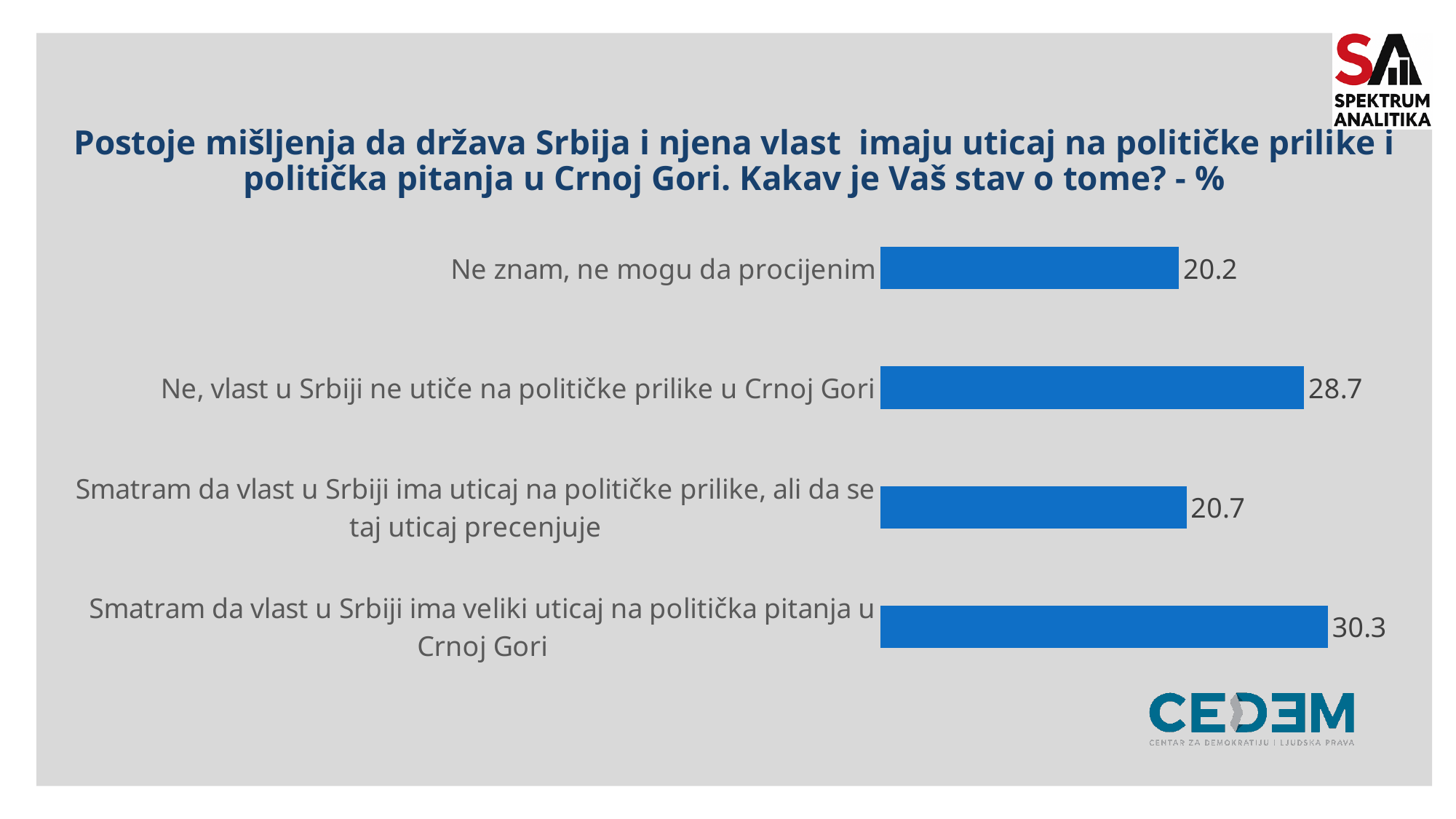
What is the value for "Smatram da vlast u Srbiji ima veliki uticaj na politička pitanja u Crnoj Gori"? 30.3 What is the value for "Ne, vlast u Srbiji ne utiče na političke prilike u Crnoj Gori"? 28.7 How many categories are shown in the chart? 4 What kind of chart is shown on the slide? Bar chart Which category has the highest value? Smatram da vlast u Srbiji ima veliki uticaj na politička pitanja u Crnoj Gori Which is larger: the value for "Ne, vlast u Srbiji ne utiče na političke prilike u Crnoj Gori" or the value for "Smatram da vlast u Srbiji ima uticaj na političke prilike, ali da se taj uticaj precenjuje"? Ne, vlast u Srbiji ne utiče na političke prilike u Crnoj Gori What is the difference between the values for "Smatram da vlast u Srbiji ima veliki uticaj na politička pitanja u Crnoj Gori" and "Ne, vlast u Srbiji ne utiče na političke prilike u Crnoj Gori"? 1.6 What is the value for "Smatram da vlast u Srbiji ima uticaj na političke prilike, ali da se taj uticaj precenjuje"? 20.7 What is the value for "Ne znam, ne mogu da procijenim"? 20.2 What is the difference between the values for "Ne, vlast u Srbiji ne utiče na političke prilike u Crnoj Gori" and "Ne znam, ne mogu da procijenim"? 8.5 What colour are the bars in the chart? Blue Which category has the lowest value? Ne znam, ne mogu da procijenim